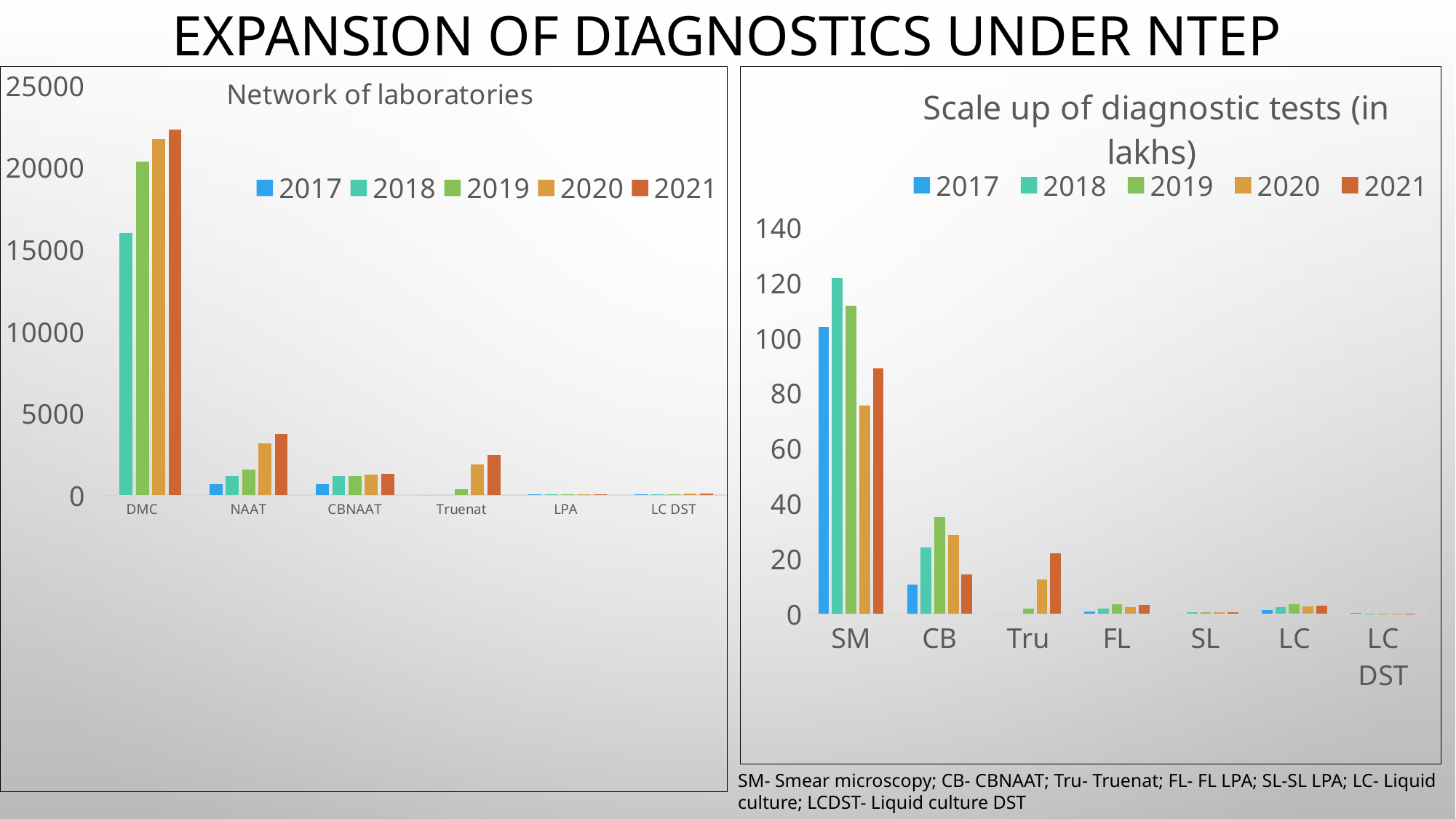
In the 'Network of laboratories' chart, is the 2018 value for DMC greater or less than 15000? greater In the 'Scale up of diagnostic tests (in lakhs)' chart, which is larger for SM: the 2018 value or the 2020 value? 2018 In the 'Network of laboratories' chart, how many categories are shown on the x axis? 6 In the 'Network of laboratories' chart, is the 2021 value for NAAT greater or less than 5000? less In the 'Network of laboratories' chart, do the DMC bars rise or fall from 2018 to 2021? Rise In the 'Network of laboratories' chart, how many series does the legend list? 5 What kind of chart is the 'Network of laboratories' chart? Bar chart In the 'Scale up of diagnostic tests (in lakhs)' chart, which category has the highest bar? SM In the 'Scale up of diagnostic tests (in lakhs)' chart, is the 2019 value for CB greater or less than 40? less In the 'Scale up of diagnostic tests (in lakhs)' chart, how many categories are shown on the x axis? 7 In the 'Network of laboratories' chart, which category has the highest bar? DMC